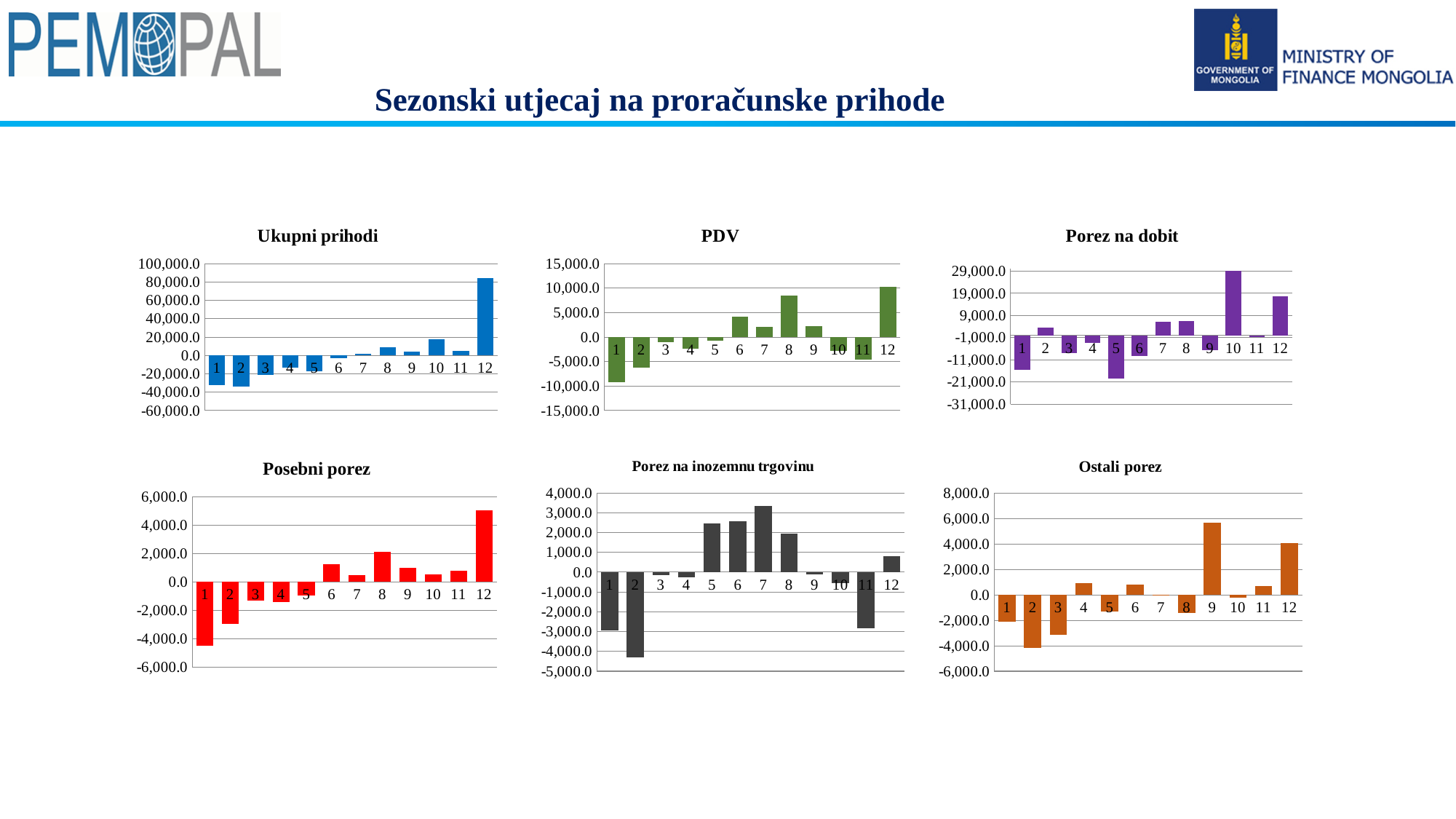
In the 'Ukupni prihodi' chart, is the value for month 12 greater or less than 60,000.0? greater In the 'Porez na dobit' chart, which month has the lowest value? 5 How many categories (months) are shown on the x axis of the 'Ostali porez' chart? 12 In the 'PDV' chart, is the value for month 8 greater or less than 5,000.0? greater What type of chart is the 'Posebni porez' chart? bar chart In the 'Ostali porez' chart, which month has the highest value? 9 In the 'Ukupni prihodi' chart, which month has the highest value? 12 In the 'Porez na inozemnu trgovinu' chart, which is larger, the value for month 7 or month 8? month 7 In the 'Porez na dobit' chart, which month has the highest value? 10 In the 'Porez na inozemnu trgovinu' chart, which month has the lowest value? 2 In the 'PDV' chart, which month has the lowest value? 1 In the 'Posebni porez' chart, is the value for month 12 greater or less than 4,000.0? greater